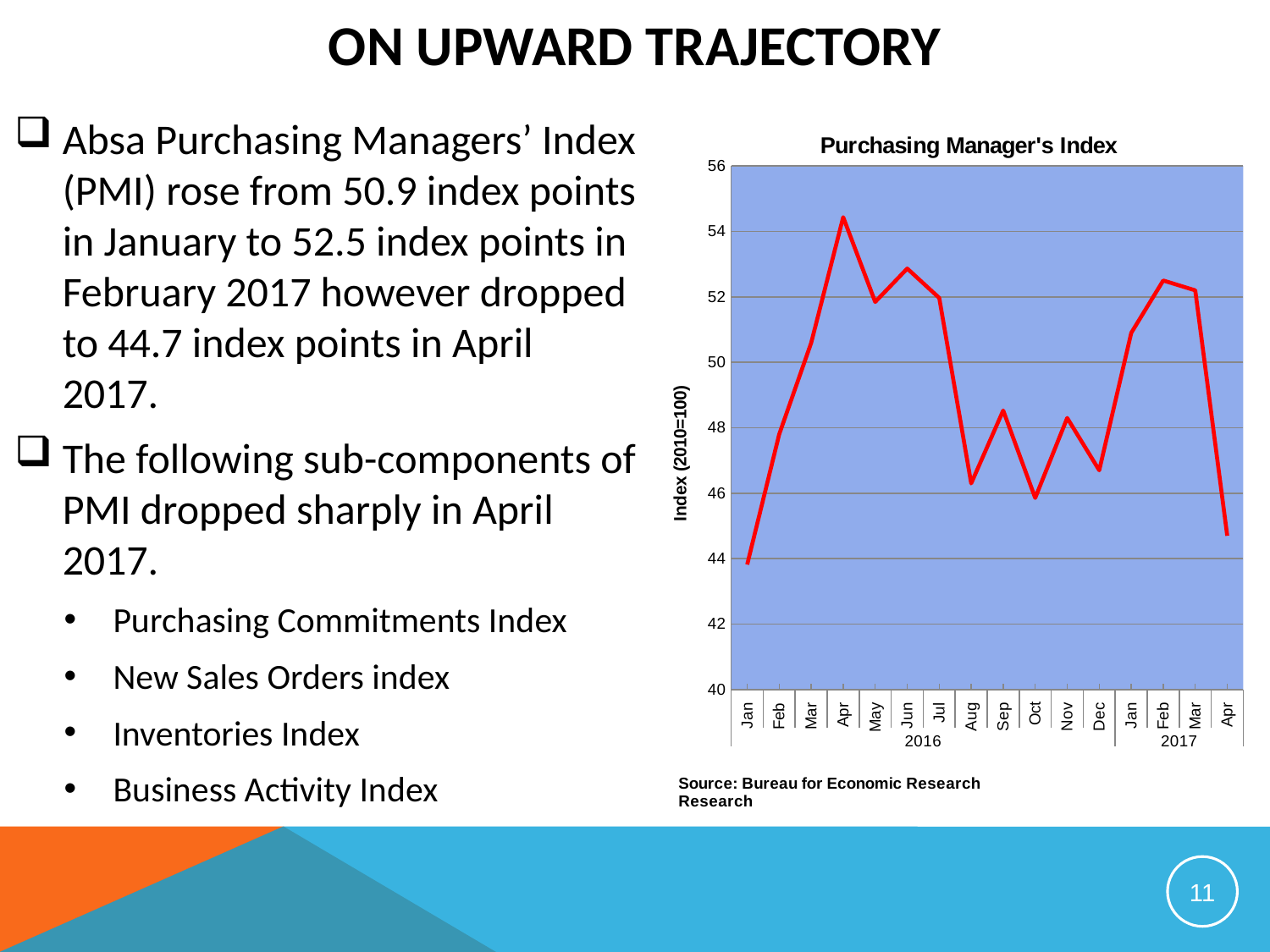
Is the value for Apr 2016 greater or less than 54? greater Which is larger, the value for Apr 2016 or the value for Feb 2017? Apr 2016 Is the value for Jan 2017 greater or less than 50? greater Is the value for Apr 2017 greater or less than 46? less In which month does the Purchasing Manager's Index reach its highest value on the chart? Apr 2016 How many monthly data points are plotted on the chart? 16 Which is larger, the value for Sep 2016 or the value for Oct 2016? Sep 2016 Does the index rise or fall between Dec 2016 and Feb 2017? rise What is the label on the vertical axis of the chart? Index (2010=100) What kind of chart is shown on the slide? line chart What is the title of the chart? Purchasing Manager's Index